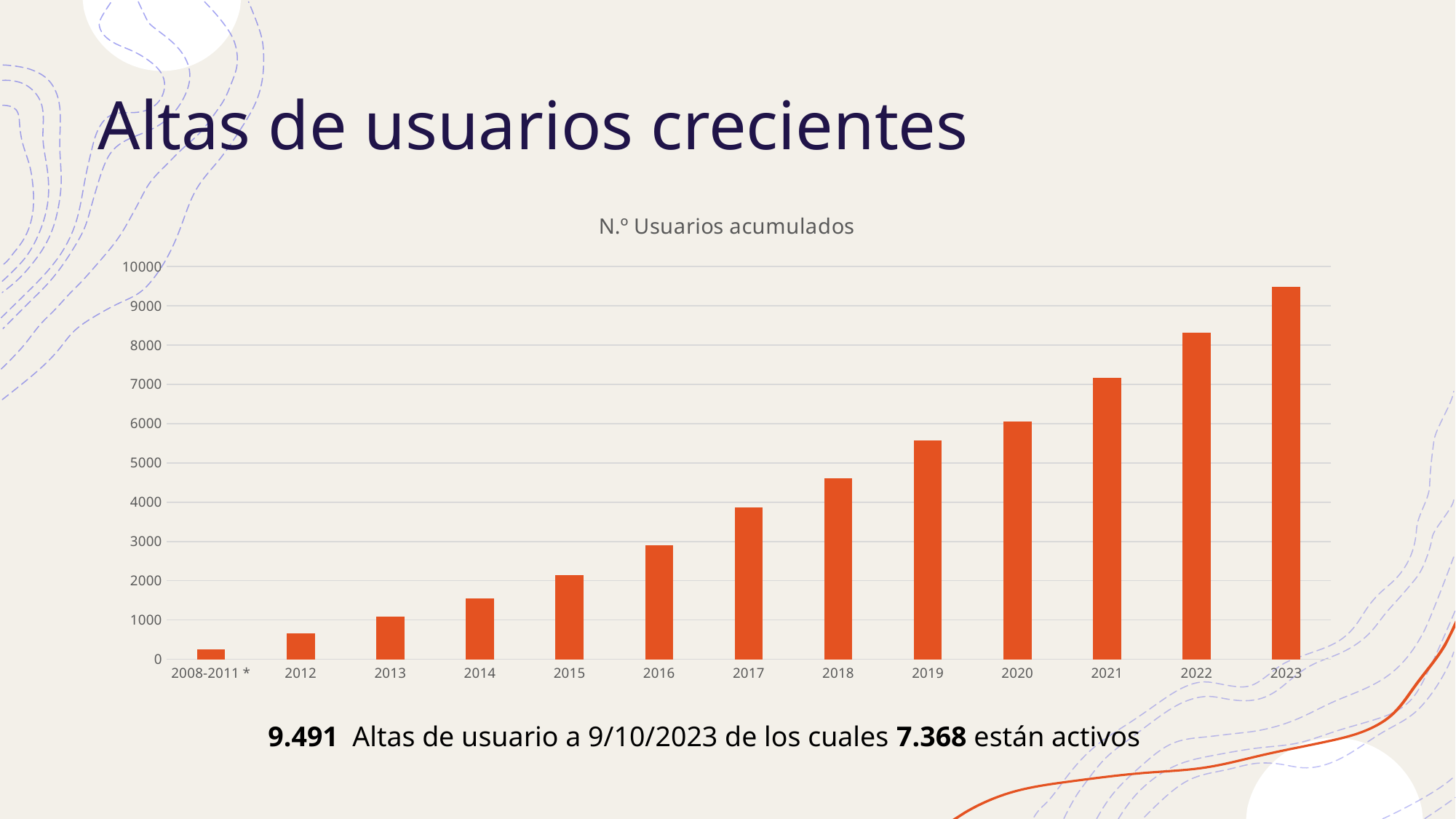
Is the value for 2012 greater or less than 1000? less What is the title of the chart? N.º Usuarios acumulados What kind of chart is shown on the slide? bar chart Which category has the highest value in the chart? 2023 Which is larger, the value for 2019 or the value for 2018? 2019 Is the value for 2022 greater or less than 8000? greater Is the value for 2023 greater or less than 9000? greater Which category has the lowest value in the chart? 2008-2011 * How many categories are shown on the x axis of the chart? 13 Do the values rise or fall from left to right along the x axis? rise